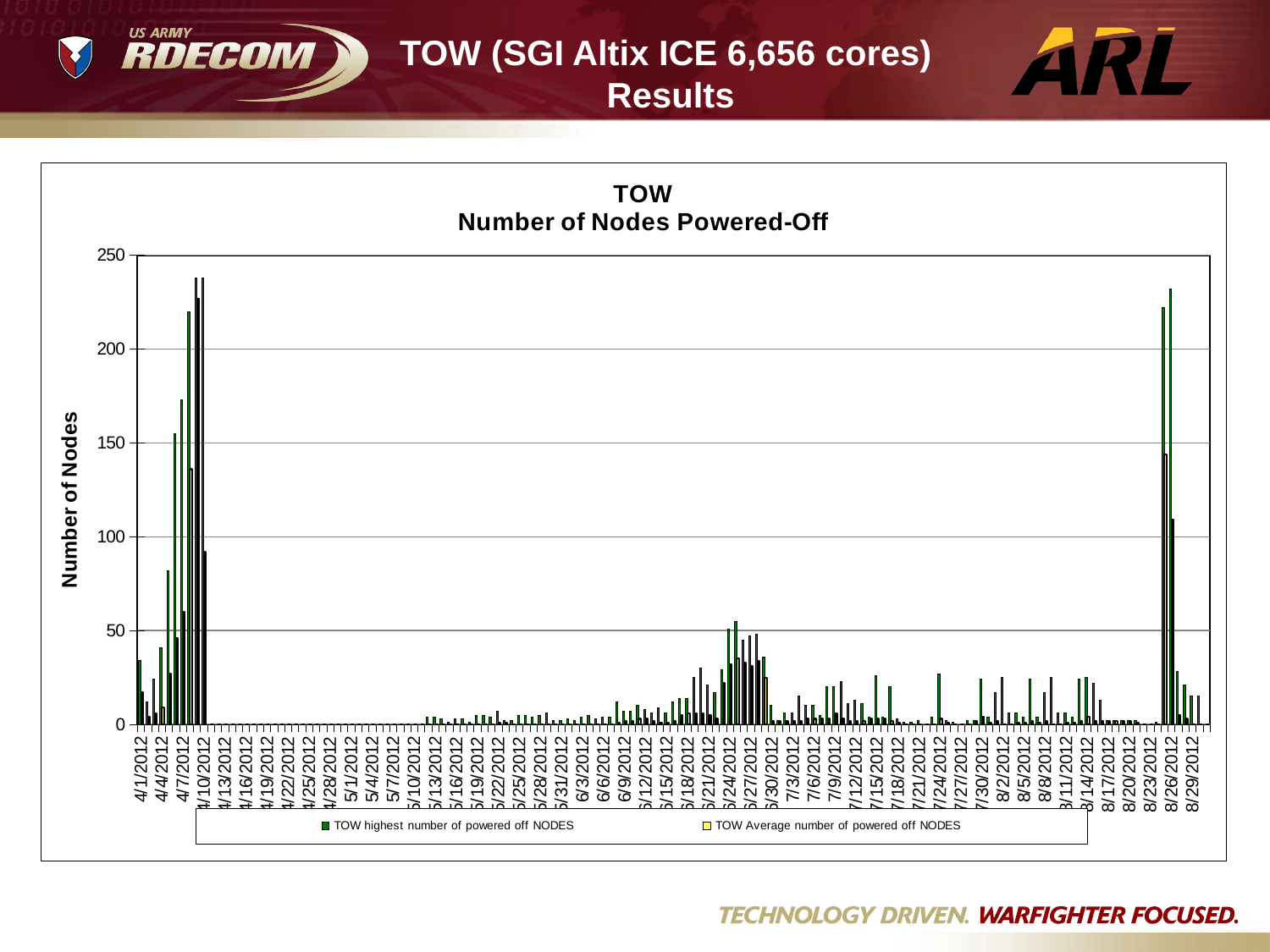
Is the peak value of the highest number of powered off nodes around 4/10/2012 greater or less than 200? greater What is the title of the chart? TOW Number of Nodes Powered-Off Is the highest number of powered off nodes on 5/13/2012 greater or less than 50? less Is the highest number of powered off nodes on 7/3/2012 greater or less than 50? less What kind of chart is shown on the slide? bar chart Which colour represents the 'TOW highest number of powered off NODES' series in the legend? green How many series does the legend list? 2 Which is larger: the peak of the highest number of powered off nodes around 8/26/2012 or the peak around 7/24/2012? around 8/26/2012 Which is larger: the peak of the highest number of powered off nodes around 4/10/2012 or the peak around 6/24/2012? around 4/10/2012